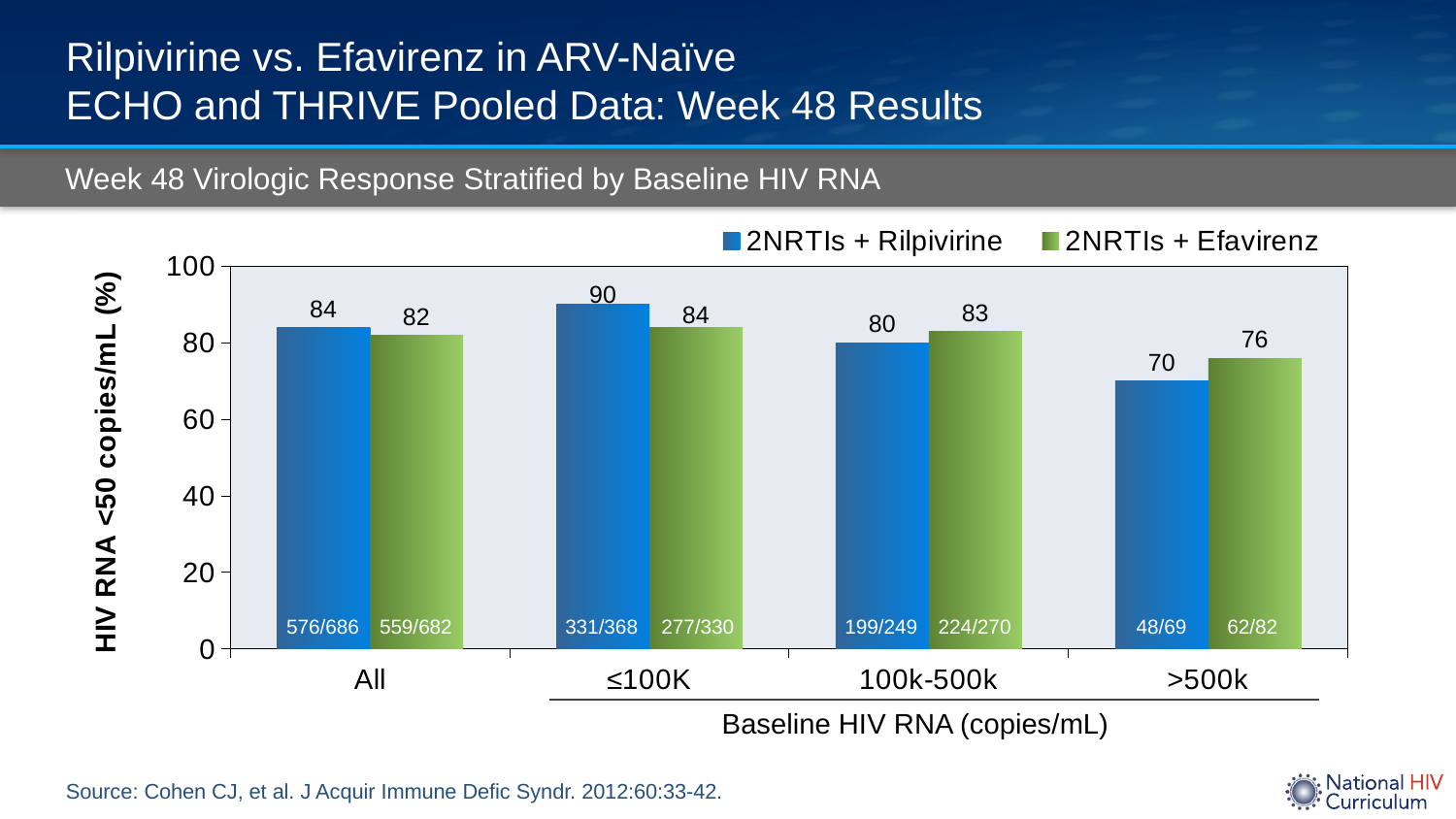
What is the difference between the 2NRTIs + Rilpivirine and 2NRTIs + Efavirenz values in the ≤100K category? 6 What is the value for 2NRTIs + Efavirenz in the 100k-500k category? 83 Which baseline HIV RNA category has the highest value for 2NRTIs + Rilpivirine? ≤100K What is the value for 2NRTIs + Efavirenz in the >500k category? 76 How many baseline HIV RNA categories are shown on the x axis? 4 What kind of chart is shown on the slide? Bar chart In the >500k category, which series has the larger value, 2NRTIs + Rilpivirine or 2NRTIs + Efavirenz? 2NRTIs + Efavirenz What is the label of the y axis? HIV RNA <50 copies/mL (%) Which baseline HIV RNA category has the lowest value for 2NRTIs + Efavirenz? >500k What is the value for 2NRTIs + Rilpivirine in the ≤100K category? 90 What is the value for 2NRTIs + Rilpivirine in the All category? 84 How many series does the legend list? 2